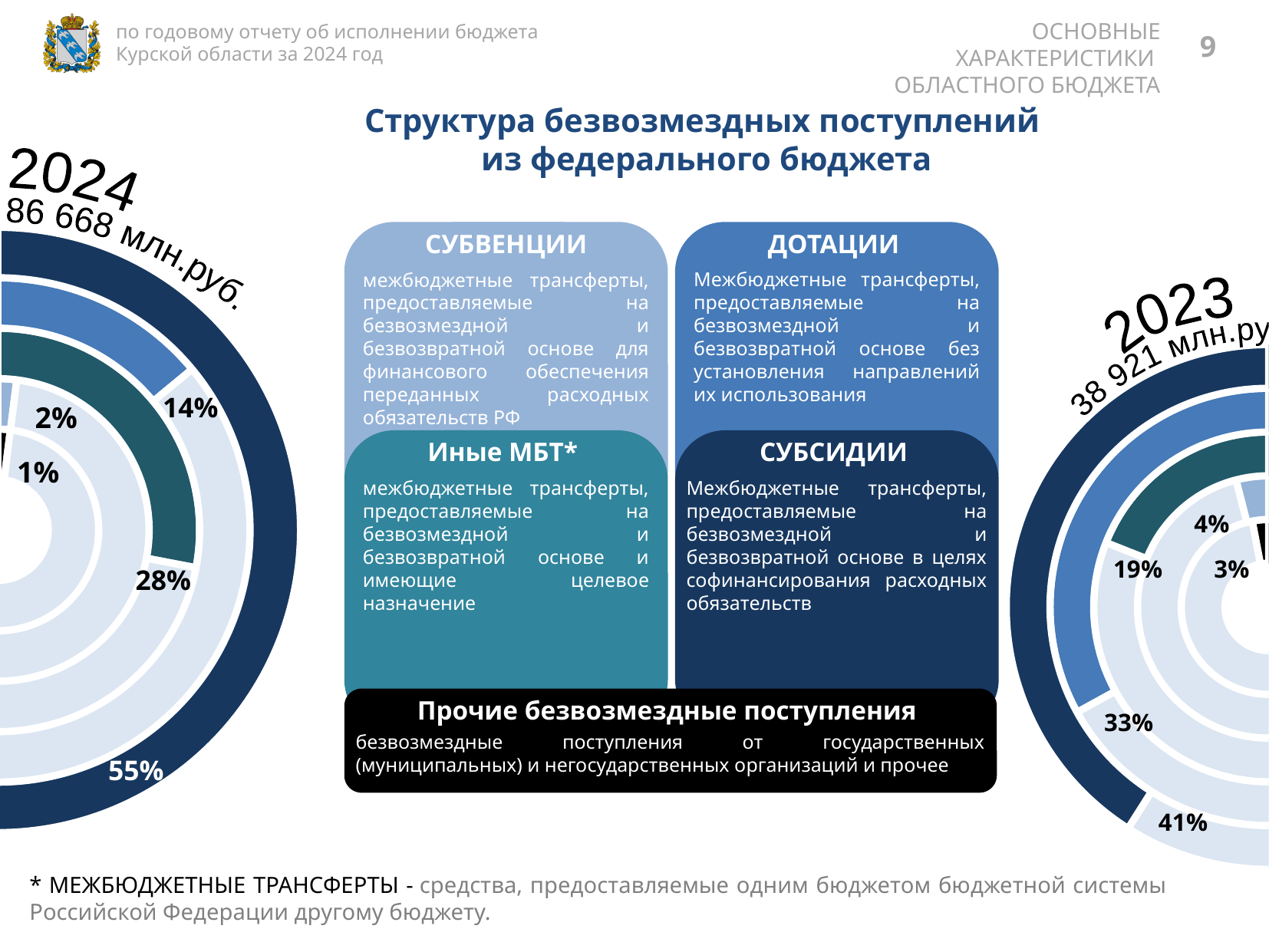
On the 2023 chart, what is the largest share shown? 41% What type of chart is used to show the structure for 2024 and 2023? Doughnut (ring) chart How many segments with percentage labels does the 2024 chart show? 5 On the 2023 chart, what share is shown for the teal ring (Иные МБТ)? 19% On the 2024 chart, what share is shown for the teal ring (Иные МБТ)? 28% What total amount is shown for 2023 on the right chart? 38 921 млн.руб. On the 2024 chart, what is the largest share shown? 55% On the 2024 chart, what is the smallest share shown? 1% What is the difference between the largest share on the 2024 chart (55%) and the largest share on the 2023 chart (41%)? 14 percentage points Which is larger: the 28% share on the 2024 chart or the 33% share on the 2023 chart? 33% on the 2023 chart What total amount is shown for 2024 on the left chart? 86 668 млн.руб. On the 2023 chart, what is the smallest share shown? 3%